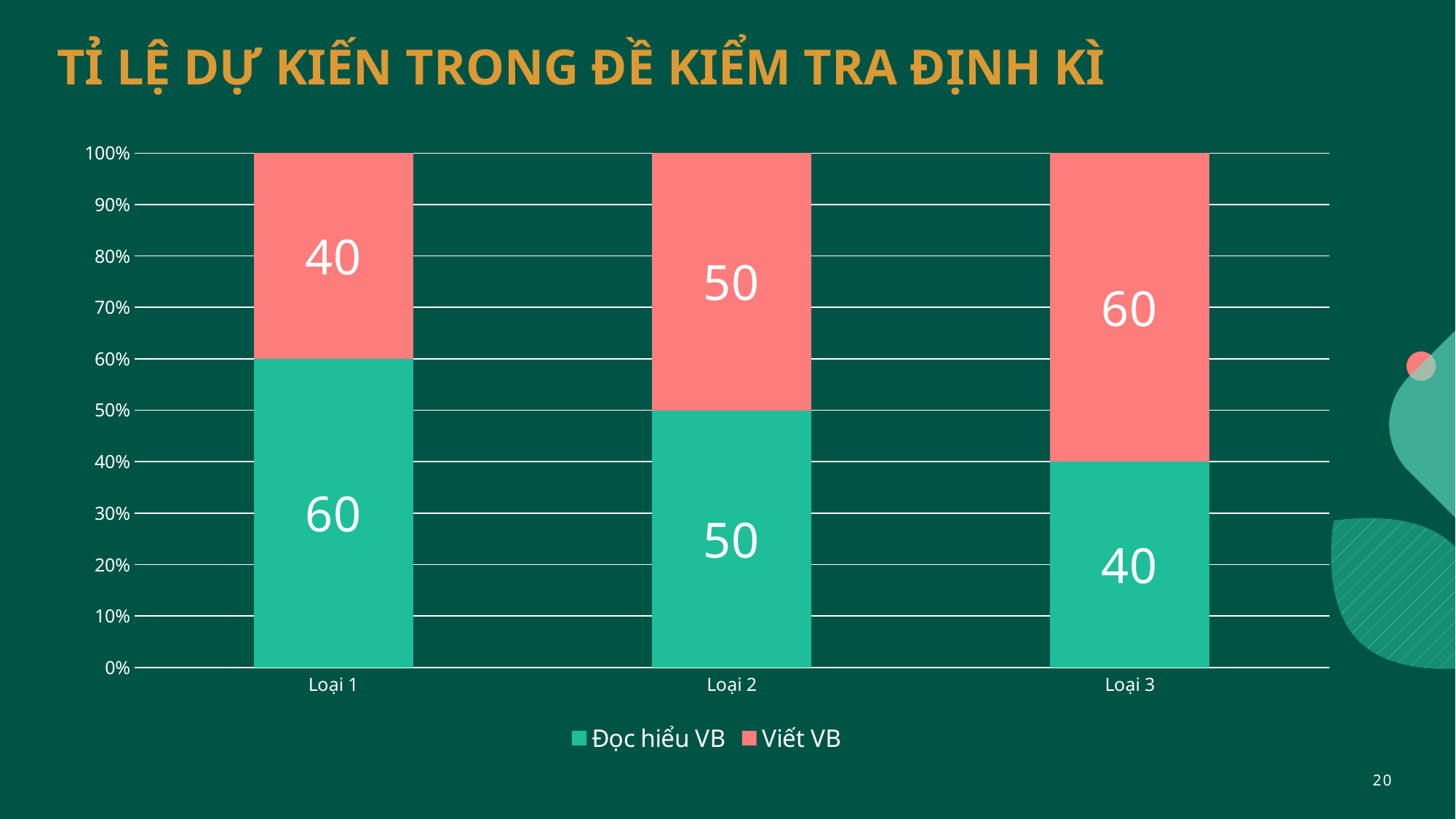
What is the value of Viết VB for Loại 3? 60 Do the Viết VB values rise or fall from Loại 1 to Loại 3? Rise How many categories are shown on the x axis? 3 What is the difference between the Viết VB value for Loại 3 and the Viết VB value for Loại 1? 20 Which category has the lowest value for Viết VB? Loại 1 What is the value of Viết VB for Loại 2? 50 What kind of chart is shown on the slide? Stacked bar chart Which category has the highest value for Đọc hiểu VB? Loại 1 Which is larger: Đọc hiểu VB for Loại 1 or Đọc hiểu VB for Loại 3? Đọc hiểu VB for Loại 1 What is the title of the chart on the slide? TỈ LỆ DỰ KIẾN TRONG ĐỀ KIỂM TRA ĐỊNH KÌ What is the value of Đọc hiểu VB for Loại 1? 60 How many series does the legend list? 2